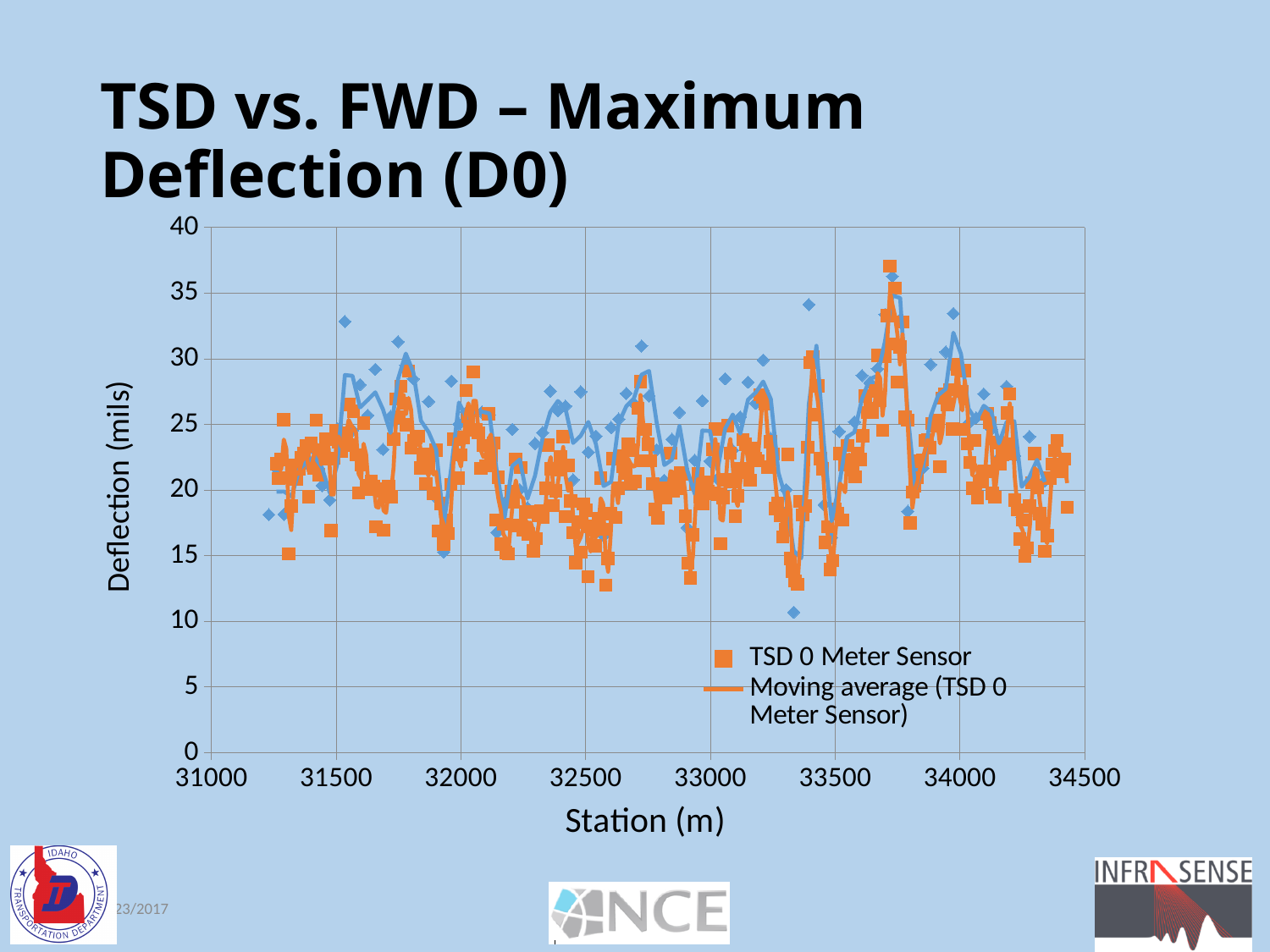
Is the lowest value plotted for the TSD 0 Meter Sensor greater or less than 10? greater Is the lowest value plotted for the TSD 0 Meter Sensor greater or less than 15? less What is the minimum value shown on the horizontal axis (Station) of the chart? 31000 What is the title of the chart on the slide? TSD vs. FWD – Maximum Deflection (D0) Is the highest value plotted for the TSD 0 Meter Sensor greater or less than 40? less What kind of chart is shown on the slide? Scatter chart How many entries does the chart legend list? 2 What label is shown on the vertical axis of the chart? Deflection (mils) What is the maximum value shown on the horizontal axis (Station) of the chart? 34500 What is the maximum value shown on the vertical axis of the chart? 40